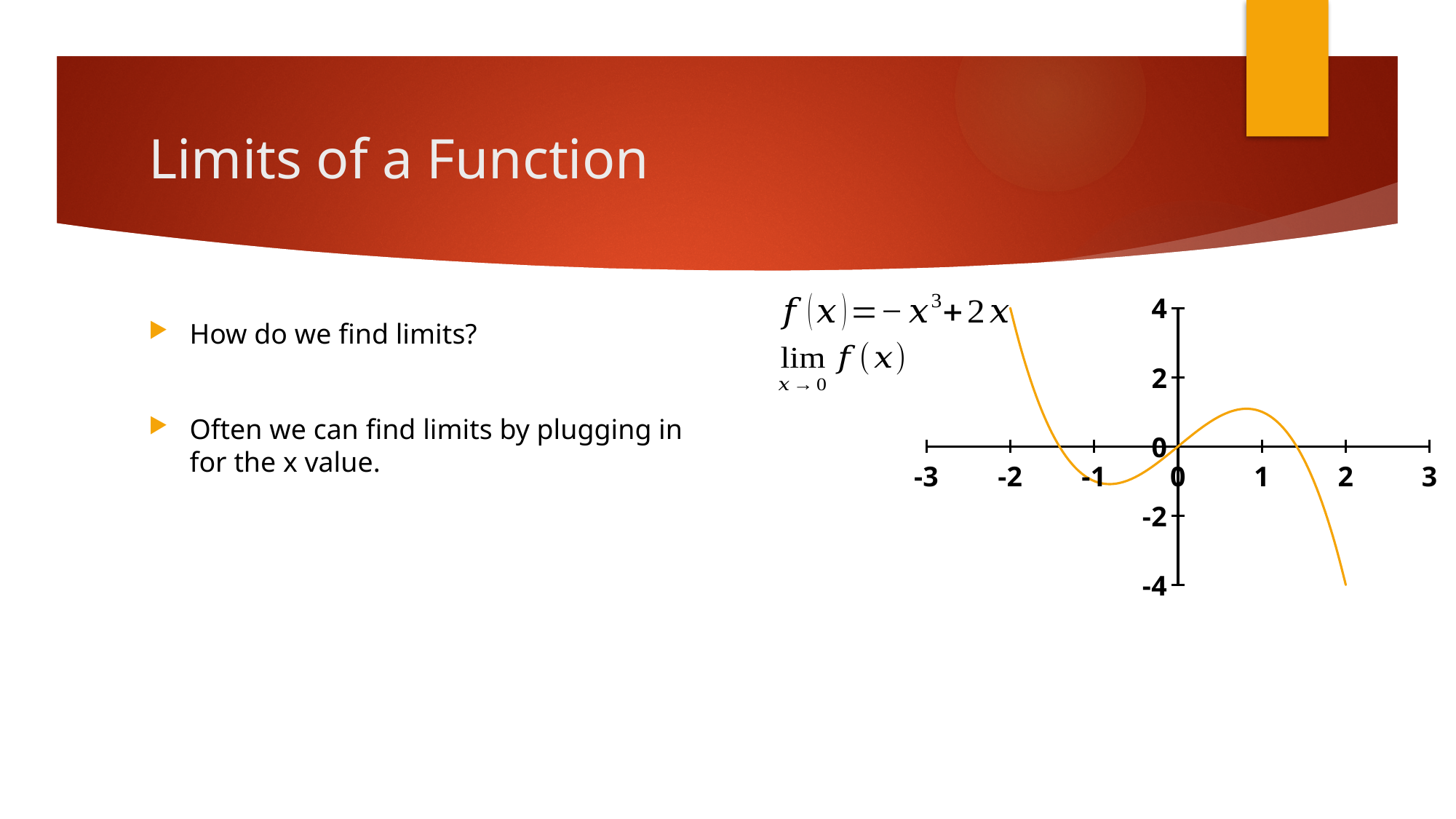
What is the value of the plotted curve at x = -2, where the curve starts on the left? 4 What kind of chart is shown on the slide? line chart Does the curve rise or fall as x goes from 1 to 2? fall What is the highest value labelled on the y axis? 4 Is the value of the curve at x = 1 greater or less than 2? less Does the curve rise or fall as x goes from -1 to 0? rise What is the value of the plotted curve at x = 2, where the curve ends on the right? -4 Is the value of the curve at x = -1 greater or less than 0? less What is the value of the plotted curve at x = 0? 0 Is the value of the curve at x = 1 greater or less than 0? greater Which is larger, the value of the curve at x = -2 or at x = 2? x = -2 How many labelled tick marks are on the x axis? 7